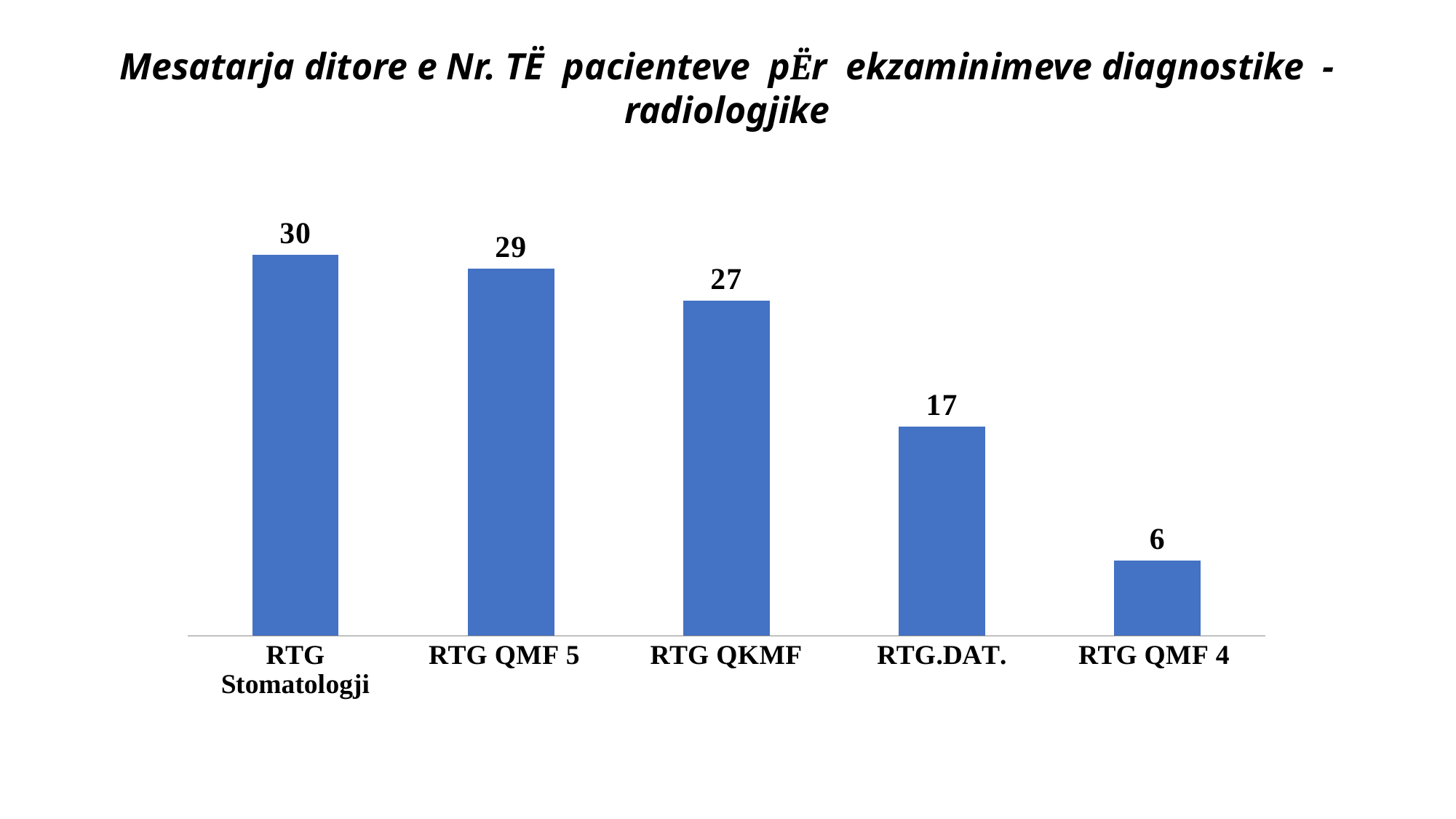
What is the value for RTG.DAT.? 17 Which is larger, the value for RTG QKMF or the value for RTG.DAT.? RTG QKMF Which category has the highest value? RTG Stomatologji What is the value for RTG Stomatologji? 30 What is the difference between the values for RTG Stomatologji and RTG QMF 4? 24 Which category has the lowest value? RTG QMF 4 How many categories are shown in the chart? 5 What is the value for RTG QMF 5? 29 What is the difference between the values for RTG QKMF and RTG.DAT.? 10 What is the value for RTG QKMF? 27 What kind of chart is shown on the slide? Bar chart What is the value for RTG QMF 4? 6